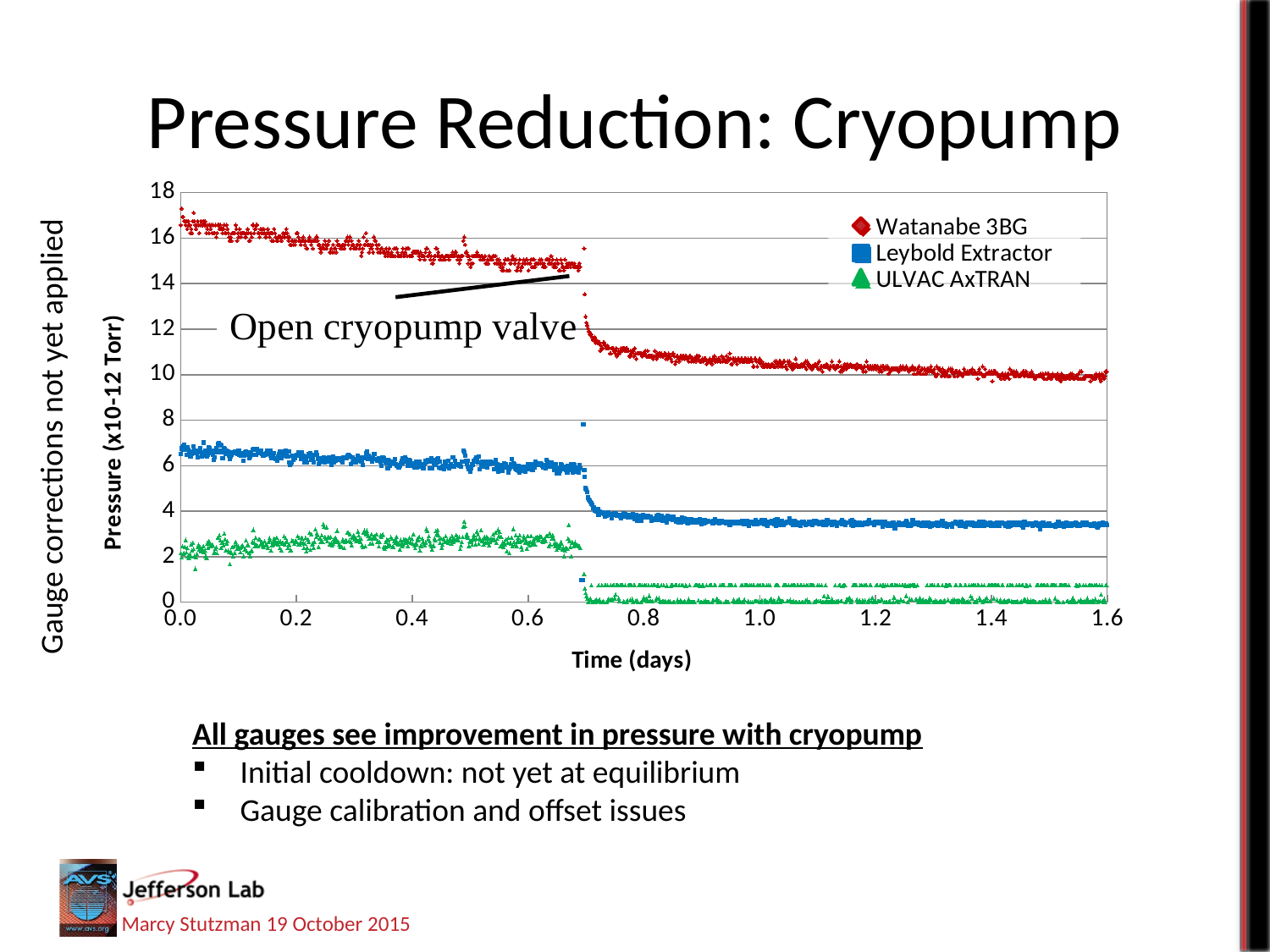
Which series has the lowest pressure values throughout the chart? ULVAC AxTRAN At time 0.4 days, which series has the larger pressure, Leybold Extractor or ULVAC AxTRAN? Leybold Extractor Is the Leybold Extractor pressure at time 1.2 days greater or less than 6? less Is the Watanabe 3BG pressure at time 1.4 days greater or less than 12? less Is the ULVAC AxTRAN pressure at time 1.0 days greater or less than 2? less What is the label of the x axis of the chart? Time (days) Which series has the highest pressure values throughout the chart? Watanabe 3BG What kind of chart is shown on the slide? scatter chart Do the pressure values for the Watanabe 3BG series rise or fall as time increases? fall How many series does the chart legend list? 3